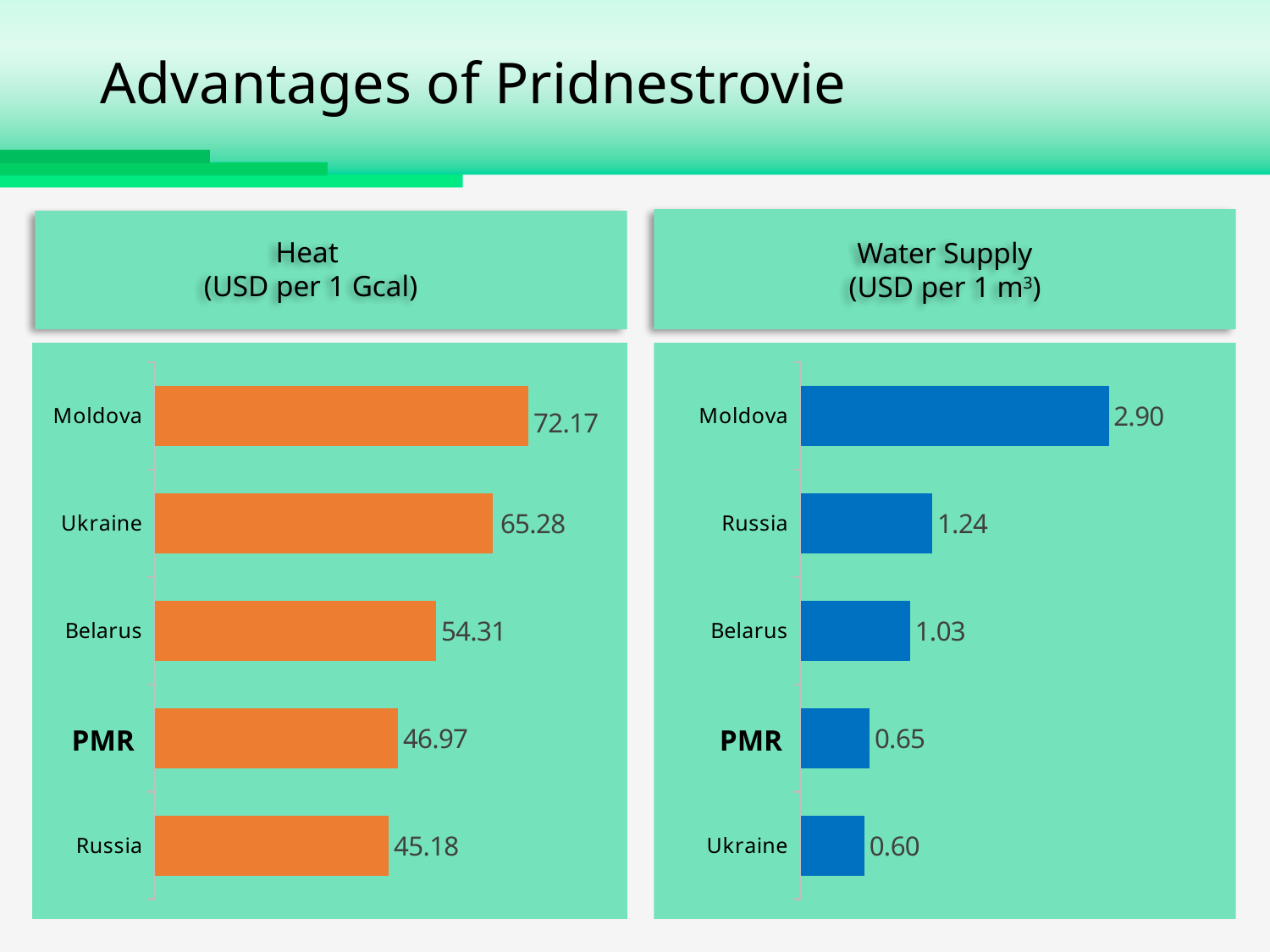
In the Heat chart, which country has the lowest value? Russia What kind of chart is the Heat chart? Bar chart In the Water Supply chart, which country has the highest value? Moldova In the Heat chart, what is the difference between the values for Moldova and PMR? 25.20 How many countries are shown in the Water Supply chart? 5 In the Heat chart, what is the value for Moldova? 72.17 In the Water Supply chart, what is the value for Ukraine? 0.60 In the Water Supply chart, what is the value for Russia? 1.24 In the Water Supply chart, what is the difference between the values for Moldova and Belarus? 1.87 In the Heat chart, what is the value for PMR? 46.97 In the Heat chart, which is larger, the value for Ukraine or the value for Belarus? Ukraine What colour are the bars in the Water Supply chart? Blue